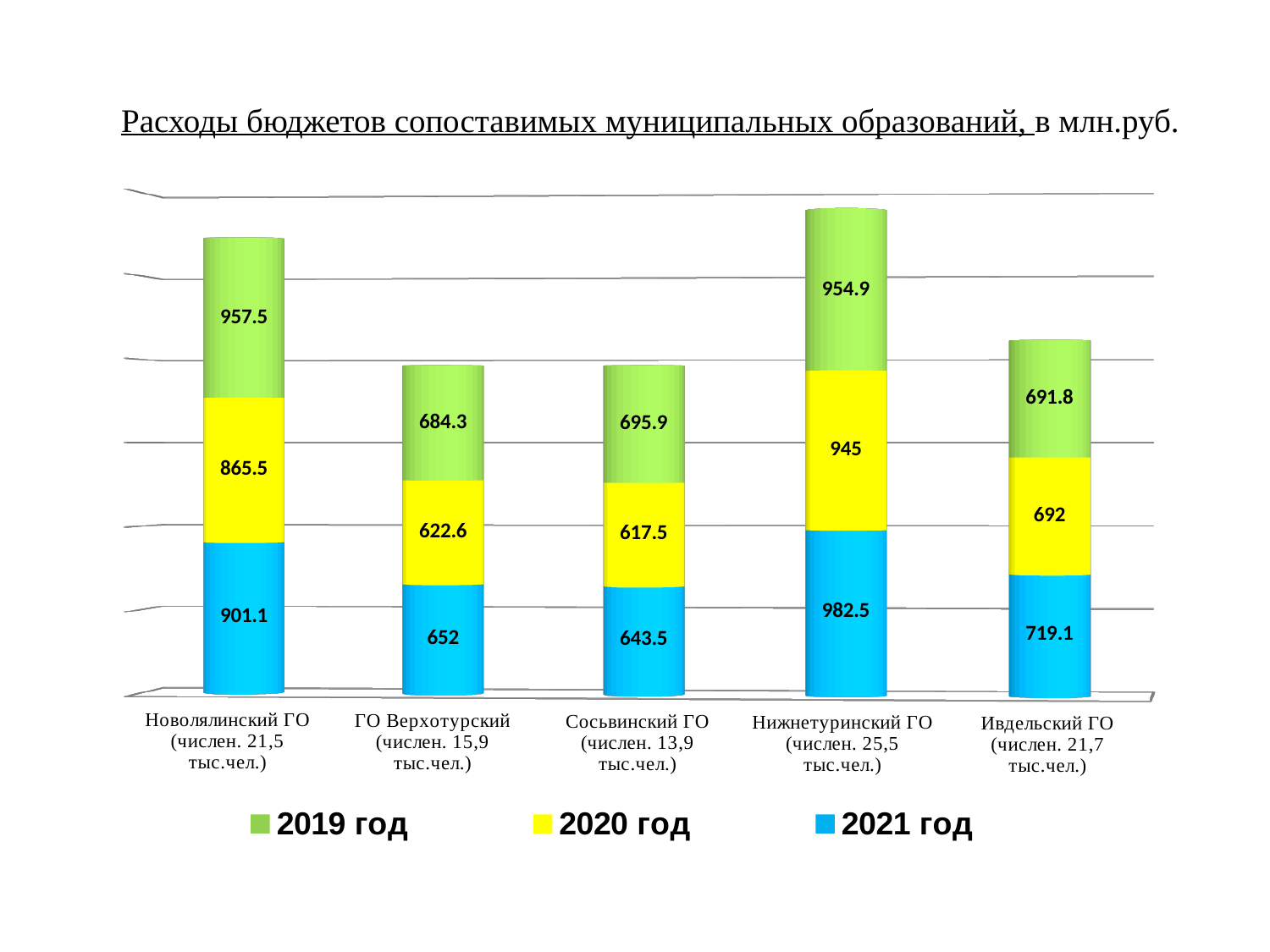
What is the 2019 год value for Новолялинский ГО? 957.5 What is the 2020 год value for Сосьвинский ГО? 617.5 What is the 2021 год value for Нижнетуринский ГО? 982.5 Which colour represents 2020 год in the legend? Yellow How many series does the legend list? 3 Which municipality has the highest 2021 год value? Нижнетуринский ГО What is the total of the stacked bar for Ивдельский ГО? 2102.9 Which municipality has the lowest 2020 год value? Сосьвинский ГО What type of chart is shown on the slide? Stacked bar chart How many municipalities (categories) are shown on the x axis? 5 Which is larger: the 2021 год value for ГО Верхотурский or for Сосьвинский ГО? ГО Верхотурский What is the difference between the 2019 год values of Новолялинский ГО and Ивдельский ГО? 265.7